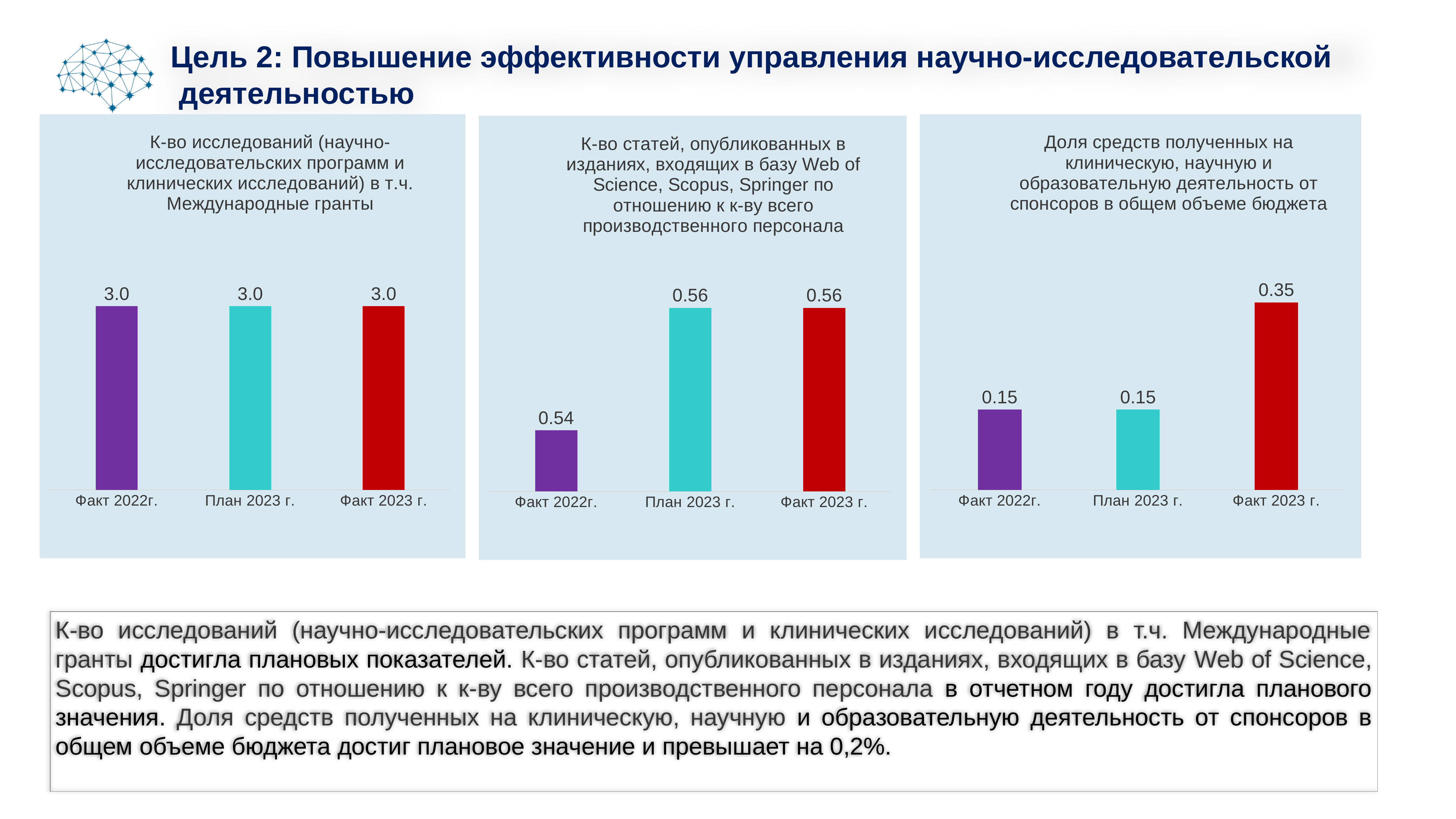
In the right chart (Доля средств полученных ... от спонсоров), what is the value for План 2023 г.? 0.15 What type of chart is the middle chart (К-во статей, опубликованных в изданиях ...)? Bar chart In the middle chart (К-во статей, опубликованных в изданиях ...), which category has the lowest value? Факт 2022г. In the middle chart (К-во статей, опубликованных в изданиях ...), what is the value for План 2023 г.? 0.56 In the right chart (Доля средств полученных ... от спонсоров), which category has the highest value? Факт 2023 г. In the left chart (К-во исследований ... Международные гранты), what is the value for Факт 2023 г.? 3.0 How many categories are shown in the left chart (К-во исследований ... Международные гранты)? 3 In the right chart (Доля средств полученных ... от спонсоров), which is larger: Факт 2022г. or Факт 2023 г.? Факт 2023 г. In the right chart (Доля средств полученных ... от спонсоров), what is the difference between Факт 2023 г. and План 2023 г.? 0.20 In the right chart (Доля средств полученных ... от спонсоров), what is the value for Факт 2023 г.? 0.35 In the middle chart (К-во статей, опубликованных в изданиях ...), what is the value for Факт 2022г.? 0.54 In the middle chart (К-во статей, опубликованных в изданиях ...), what is the difference between План 2023 г. and Факт 2022г.? 0.02